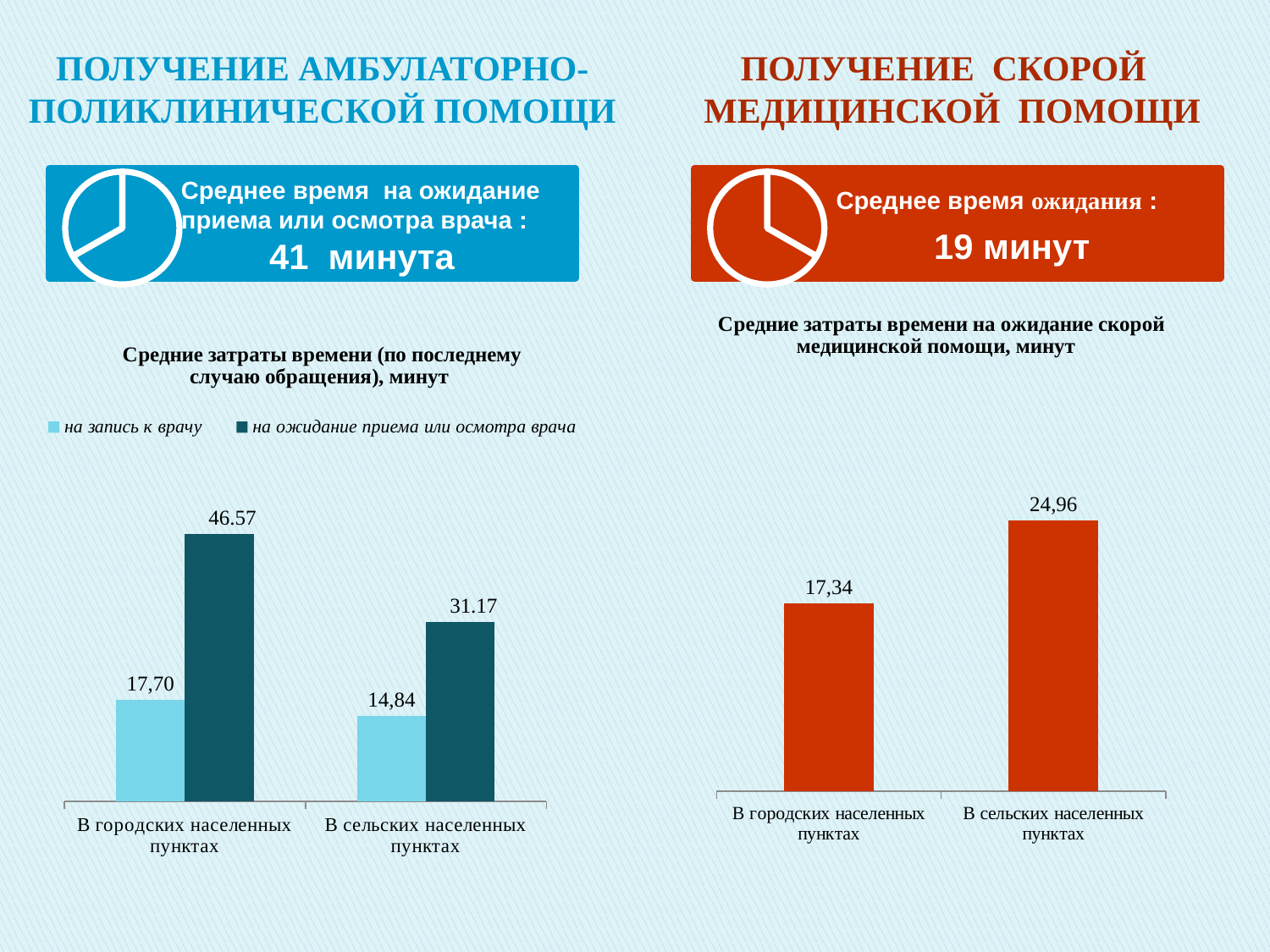
In the left chart, which series has the higher value in urban settlements? на ожидание приема или осмотра врача In the right chart (Средние затраты времени на ожидание скорой медицинской помощи, минут), what is the value for urban settlements (В городских населенных пунктах)? 17,34 What type of chart is the right chart? Bar chart In the left chart, what is the value for 'на запись к врачу' in rural settlements (В сельских населенных пунктах)? 14,84 In the right chart, what is the value for rural settlements (В сельских населенных пунктах)? 24,96 In the left chart, what is the value for 'на ожидание приема или осмотра врача' in rural settlements? 31.17 In the right chart, what is the difference between the rural and urban values? 7,62 In the left chart, what is the difference between the 'на ожидание приема или осмотра врача' values for urban and rural settlements? 15.40 In the left chart, what is the value for 'на запись к врачу' in urban settlements? 17,70 In the left chart (Средние затраты времени (по последнему случаю обращения), минут), what is the value for 'на ожидание приема или осмотра врача' in urban settlements (В городских населенных пунктах)? 46.57 In the right chart, which category has the highest value? В сельских населенных пунктах In the left chart, how many series does the legend list? 2